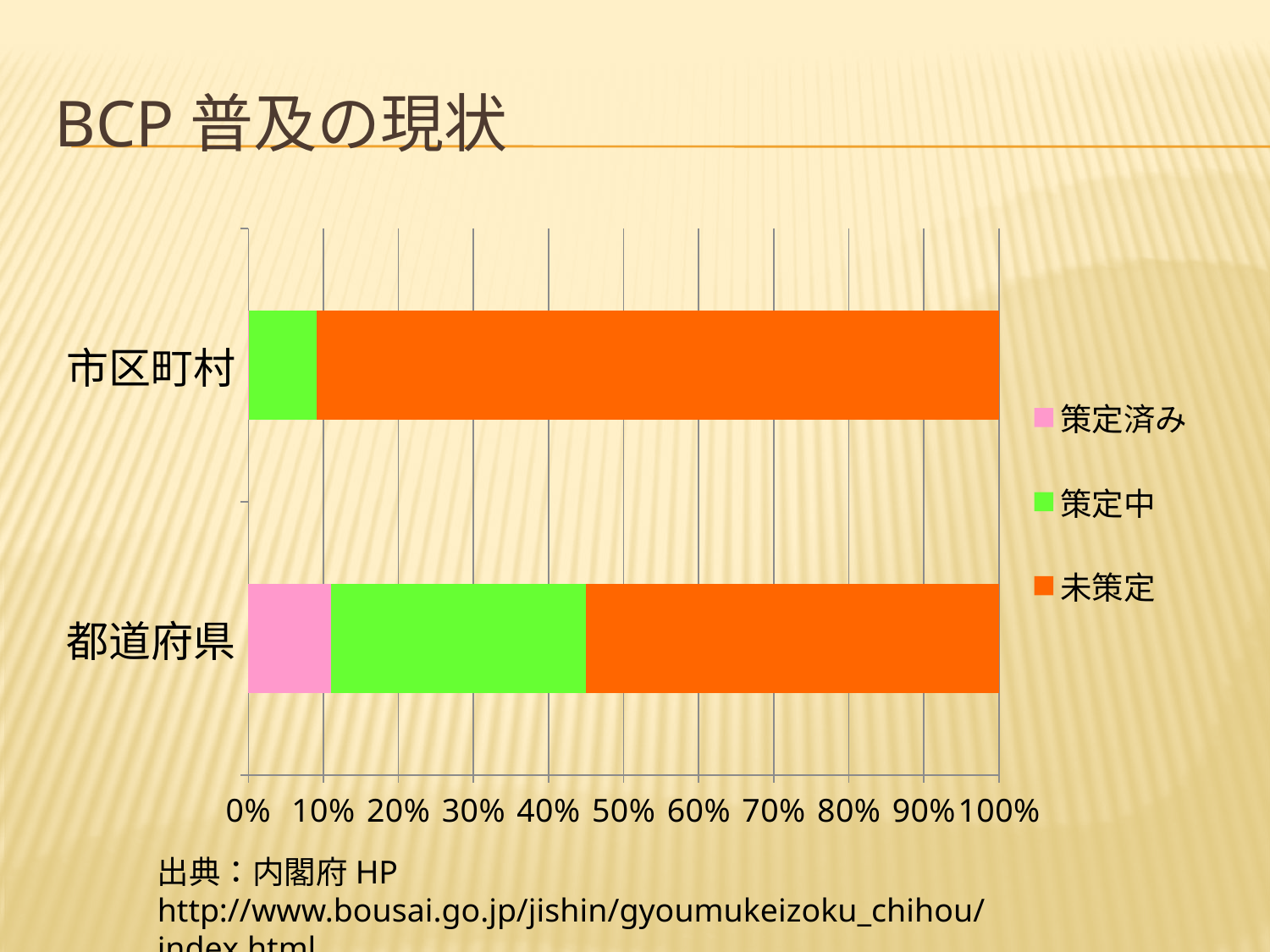
How many categories are plotted on the chart? 2 Is the 未策定 share for 都道府県 greater or less than 40%? greater How many series does the legend list? 3 What is the title of the slide containing the chart? BCP 普及の現状 Which legend entry is shown in orange? 未策定 Which series makes up the largest part of the 都道府県 bar? 未策定 Which category has the larger 未策定 share, 市区町村 or 都道府県? 市区町村 Is the 策定済み share for 都道府県 greater or less than 20%? less Is the 策定中 share for 市区町村 greater or less than 20%? less Which category has the larger 策定中 share, 市区町村 or 都道府県? 都道府県 What kind of chart is shown on the slide? stacked bar chart